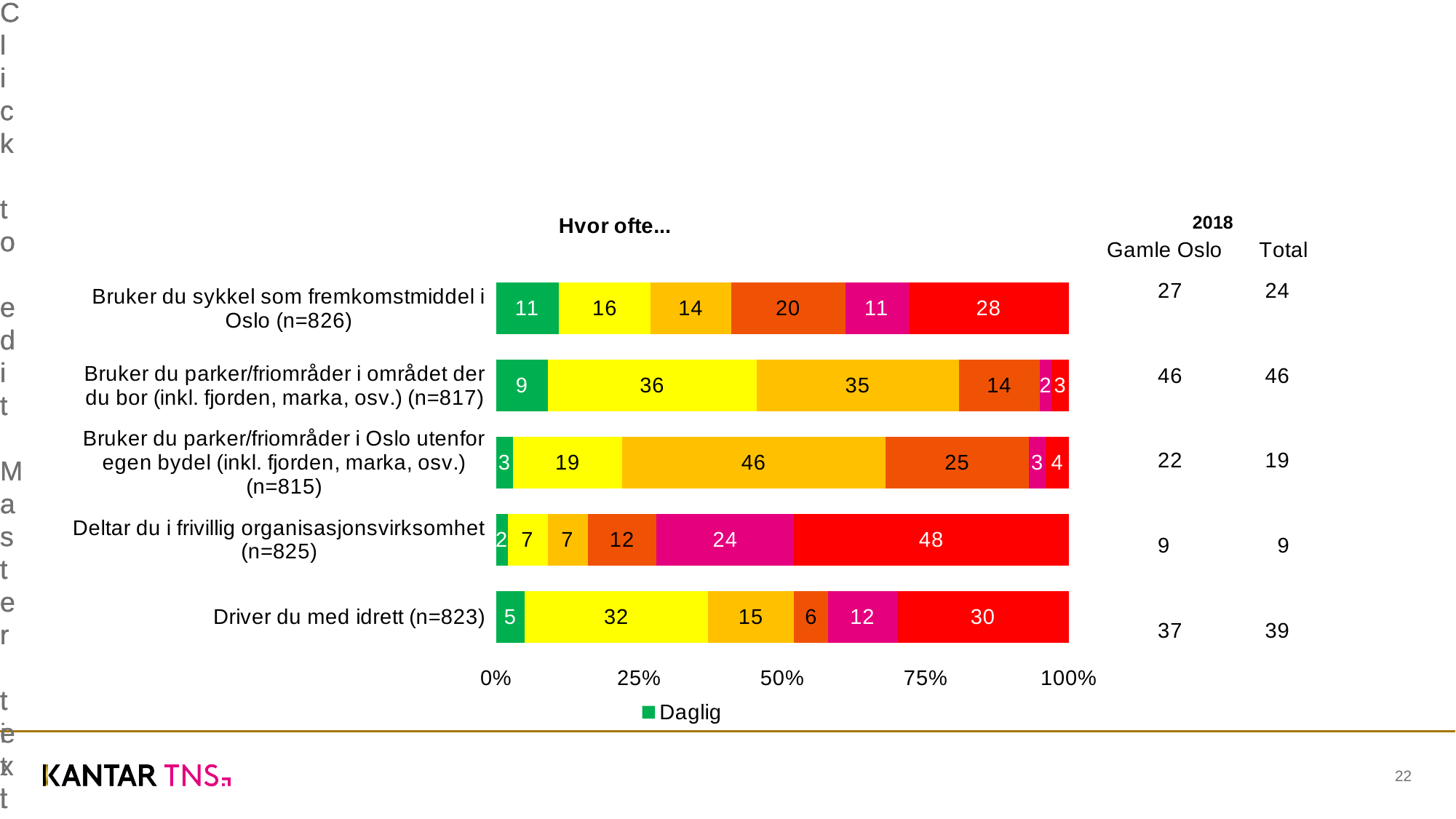
Which has the larger Daglig value: 'Bruker du parker/friområder i området der du bor (inkl. fjorden, marka, osv.) (n=817)' or 'Driver du med idrett (n=823)'? Bruker du parker/friområder i området der du bor (inkl. fjorden, marka, osv.) (n=817) How many categories (questions) are plotted in the chart? 5 What is the title of the chart? Hvor ofte... What kind of chart is shown on the slide? bar chart What is the largest segment value printed in the bar for 'Bruker du parker/friområder i Oslo utenfor egen bydel (inkl. fjorden, marka, osv.) (n=815)'? 46 What is the Daglig value for 'Bruker du sykkel som fremkomstmiddel i Oslo (n=826)'? 11 What is the difference between the Daglig value for 'Bruker du sykkel som fremkomstmiddel i Oslo (n=826)' and for 'Driver du med idrett (n=823)'? 6 What is the largest segment value printed in the bar for 'Deltar du i frivillig organisasjonsvirksomhet (n=825)'? 48 What is the Daglig value for 'Driver du med idrett (n=823)'? 5 Which category has the highest Daglig value? Bruker du sykkel som fremkomstmiddel i Oslo (n=826) Which category has the lowest Daglig value? Deltar du i frivillig organisasjonsvirksomhet (n=825) How many series does the chart legend list? 1